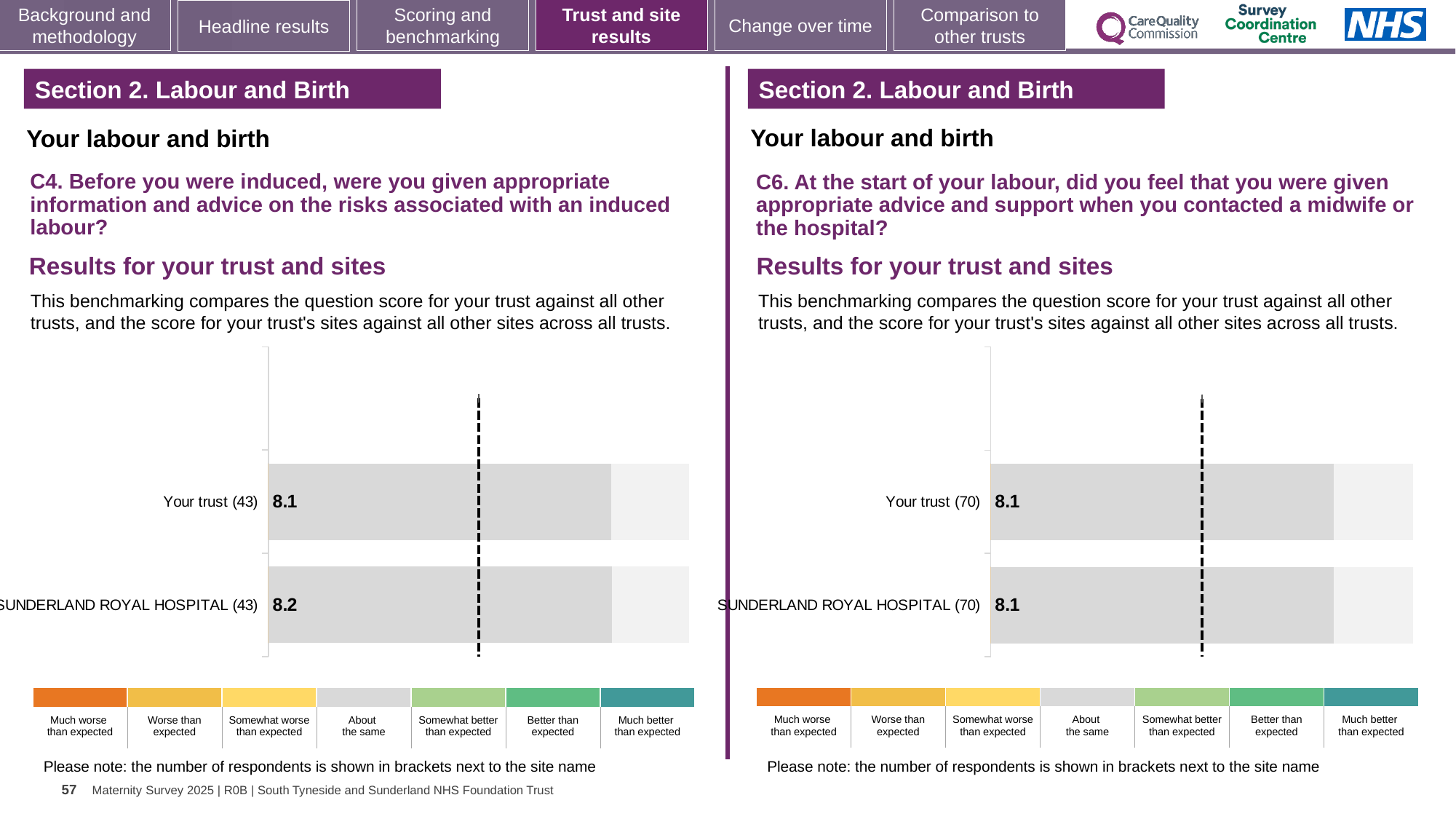
In the left chart (C4), what is the score for SUNDERLAND ROYAL HOSPITAL? 8.2 In the right chart (C6), what is the score for SUNDERLAND ROYAL HOSPITAL? 8.1 In the right chart (C6), what is the score for Your trust? 8.1 In the left chart (C4), what is the difference between the SUNDERLAND ROYAL HOSPITAL score and the Your trust score? 0.1 In the left chart (C4), which category has the highest score? SUNDERLAND ROYAL HOSPITAL In the right chart (C6), what is the difference between the Your trust score and the SUNDERLAND ROYAL HOSPITAL score? 0 In the left chart (C4), what is the score for Your trust? 8.1 What type of chart is used in the left chart (C4)? Bar chart In the left chart (C4), how many respondents are shown in brackets next to SUNDERLAND ROYAL HOSPITAL? 43 In the right chart (C6), how many respondents are shown in brackets next to Your trust? 70 How many bars are plotted in the right chart (C6)? 2 In the left chart (C4), which has the higher score, Your trust or SUNDERLAND ROYAL HOSPITAL? SUNDERLAND ROYAL HOSPITAL